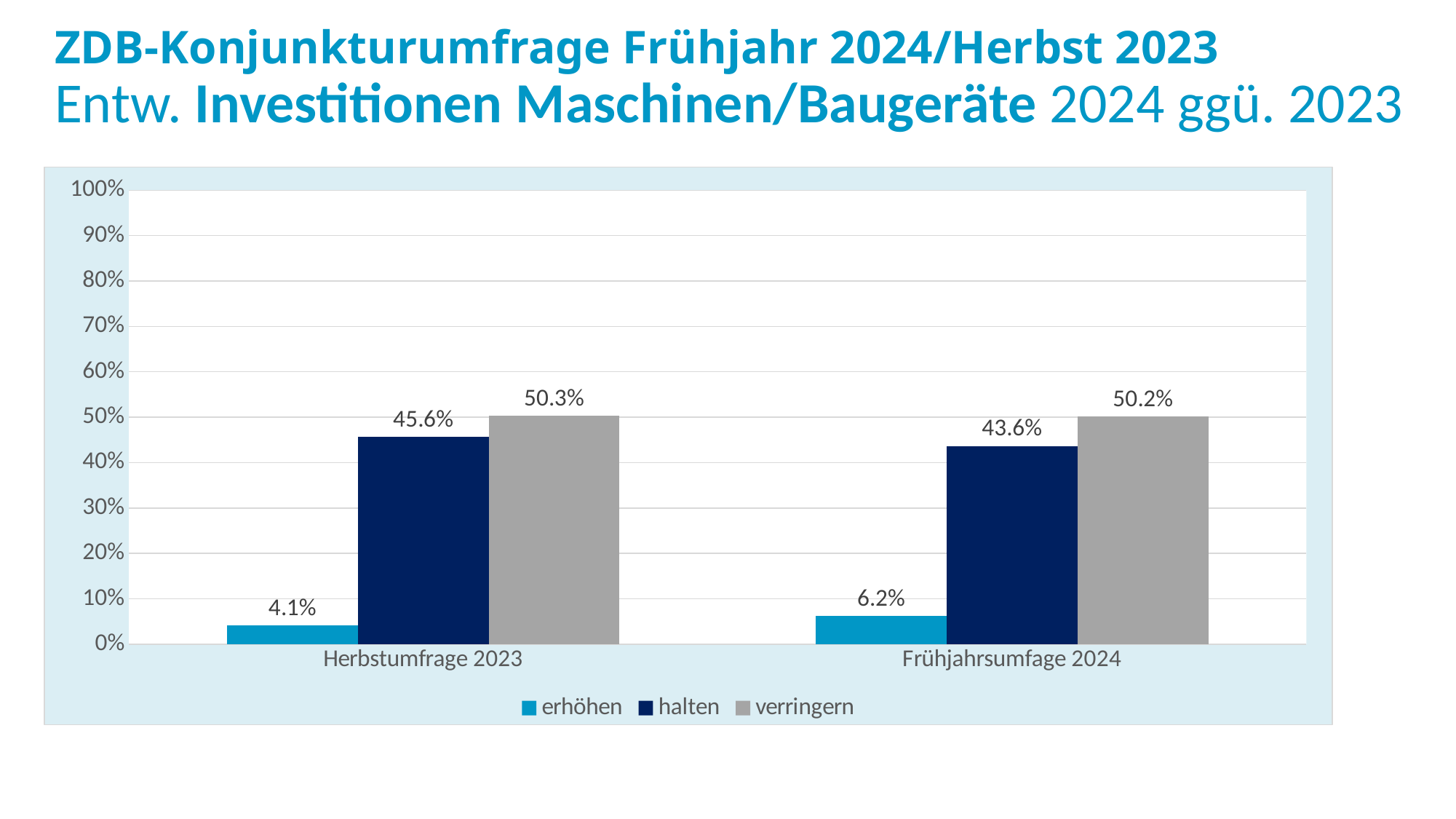
What is the difference between "halten" in Herbstumfrage 2023 and "halten" in Frühjahrsumfage 2024? 2.0% Which is larger: "erhöhen" in Herbstumfrage 2023 or "erhöhen" in Frühjahrsumfage 2024? Frühjahrsumfage 2024 Which colour represents the "halten" series? dark blue What is the value for "erhöhen" in Herbstumfrage 2023? 4.1% What is the value for "verringern" in Herbstumfrage 2023? 50.3% Which series has the lowest value in Herbstumfrage 2023? erhöhen What kind of chart is shown on the slide? bar chart What is the value for "halten" in Frühjahrsumfage 2024? 43.6% What is the value for "erhöhen" in Frühjahrsumfage 2024? 6.2% Which series has the highest value in Frühjahrsumfage 2024? verringern How many categories are shown on the x axis? 2 How many series does the legend list? 3